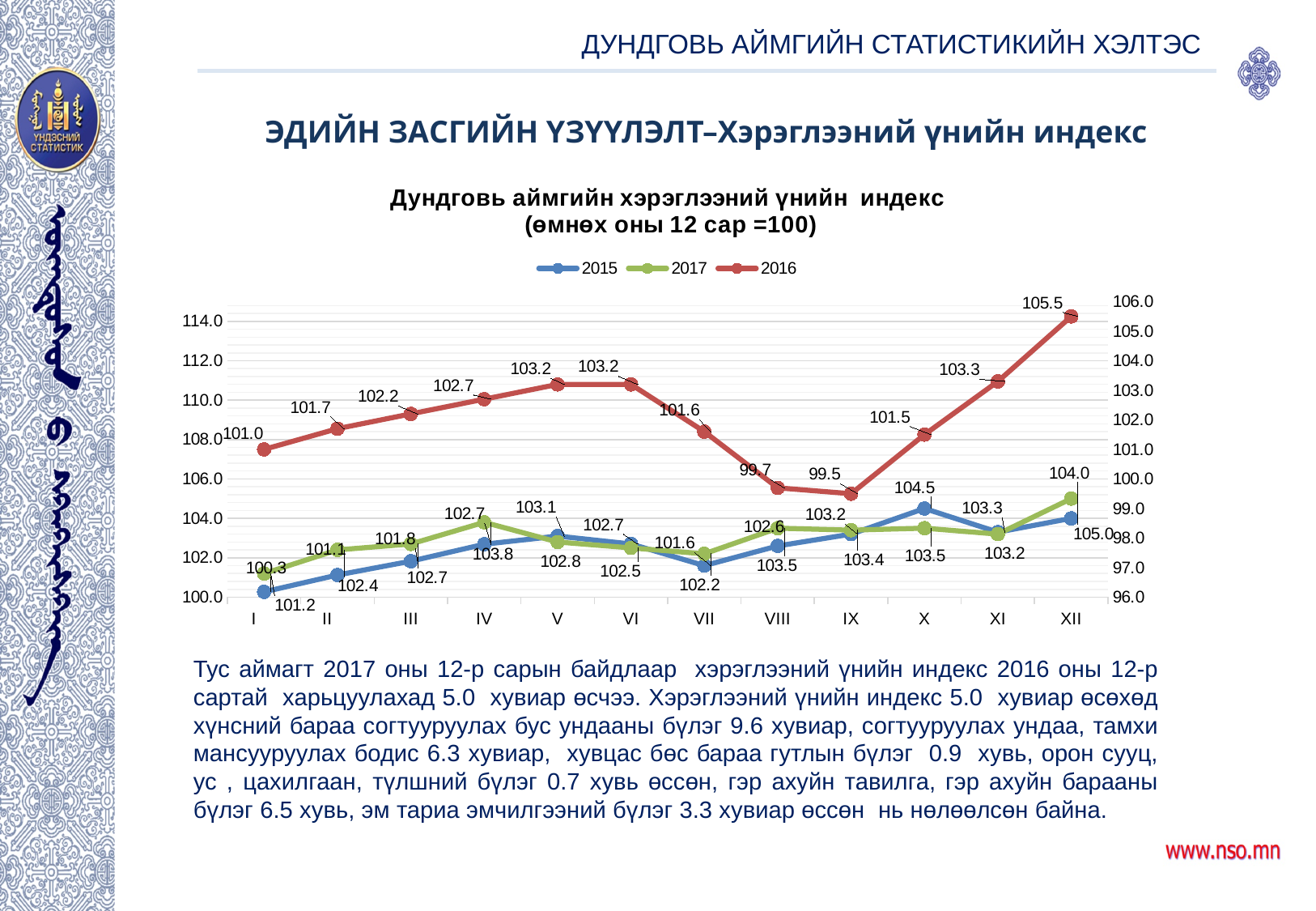
In which month is the 2016 series at its highest? XII What colour is the 2016 series line in the legend? red What is the difference between the 2016 values in month XII and month I? 4.5 What is the value of the 2016 series in month I? 101.0 What is the value of the 2016 series in month VIII? 99.7 Which is larger for the 2016 series: the value in month V or in month VIII? month V How many series does the legend list? 3 What kind of chart is shown on the slide? line chart What is the value of the 2016 series in month XII? 105.5 In which month is the 2016 series at its lowest? IX Does the 2016 series rise or fall from month VI to month IX? fall How many months (categories) are plotted along the x axis? 12